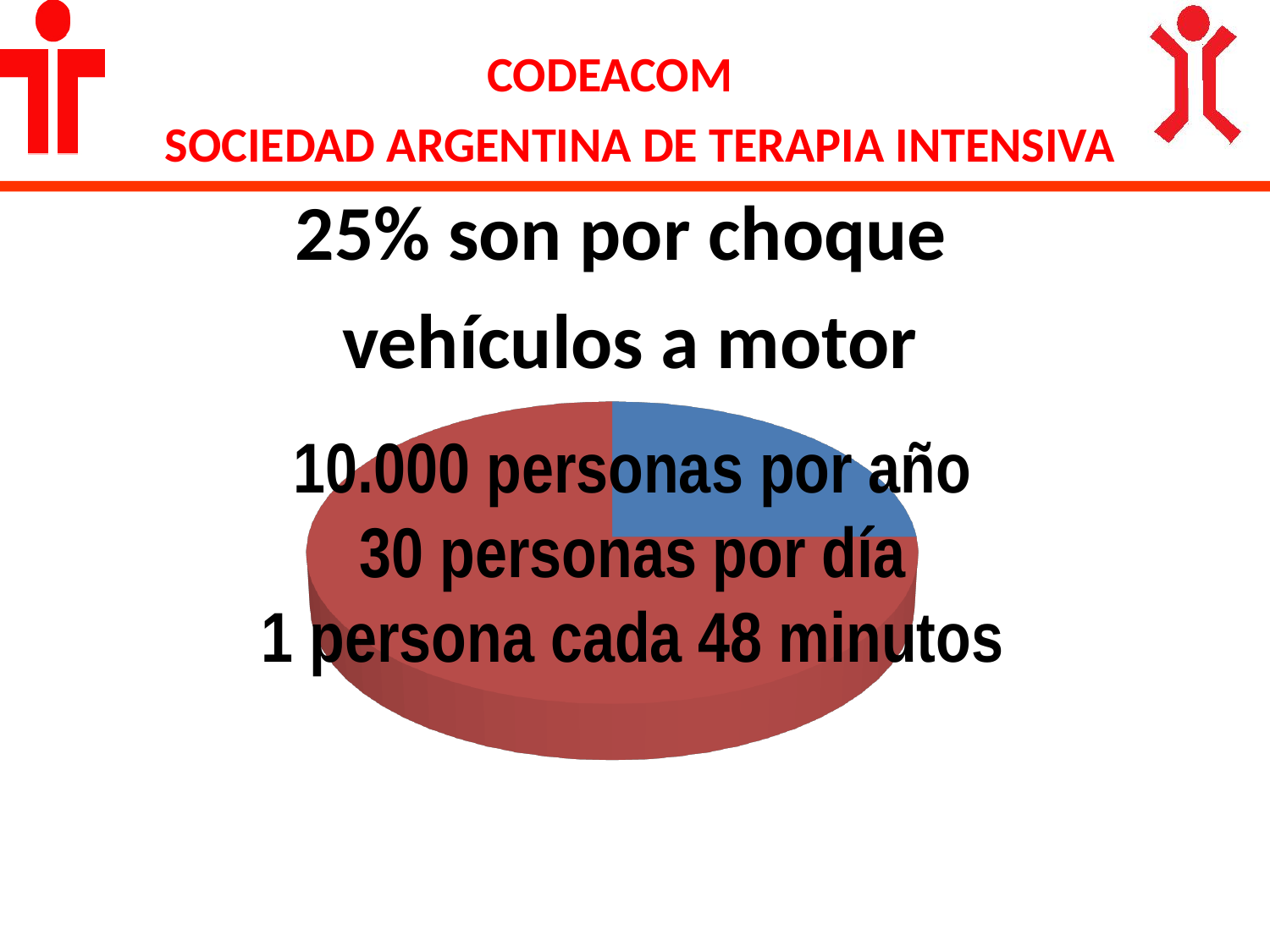
What kind of chart is shown on the slide? pie chart Which slice of the pie chart is larger, the red one or the blue one? the red one Which colour is the smallest slice of the pie chart? blue Is the pie chart drawn in 3D or flat 2D? 3D How many slices does the pie chart have? 2 Does the pie chart display a legend? No Which colour is the largest slice of the pie chart? red